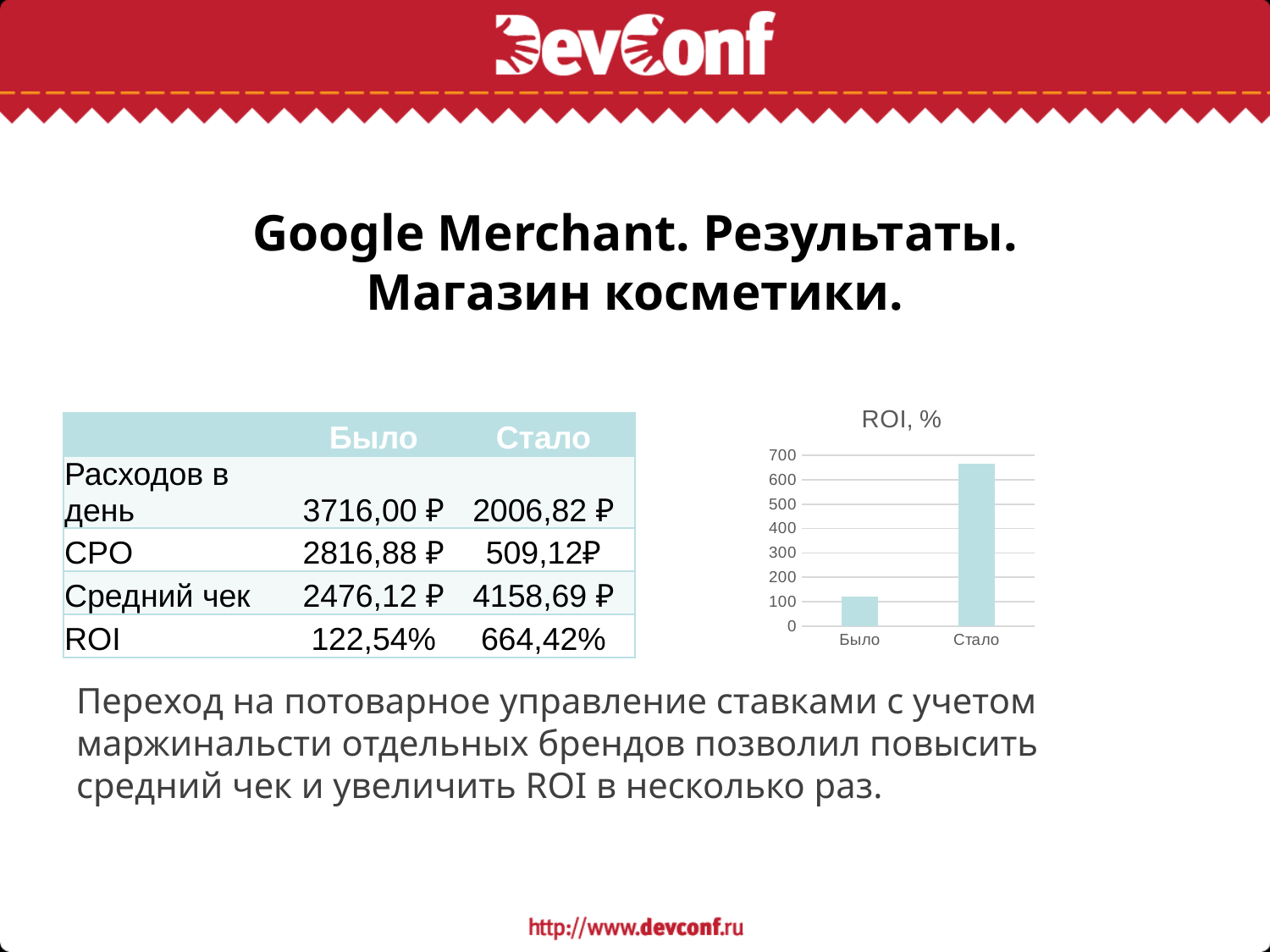
Which category has the lowest bar in the chart? Было Is the bar for Стало greater or less than 600? greater Which category has the highest bar in the chart? Стало What type of chart is shown on the slide? bar chart Do the values rise or fall from Было to Стало? rise What is the highest value shown on the chart's vertical axis? 700 Which is larger in the chart, the value for Было or the value for Стало? Стало What is the title of the chart? ROI, % Is the bar for Было greater or less than 200? less According to the table on the slide, what is the ROI value for Стало that is plotted in the chart? 664,42% Is the bar for Было greater or less than 100? greater How many bars does the chart have? 2